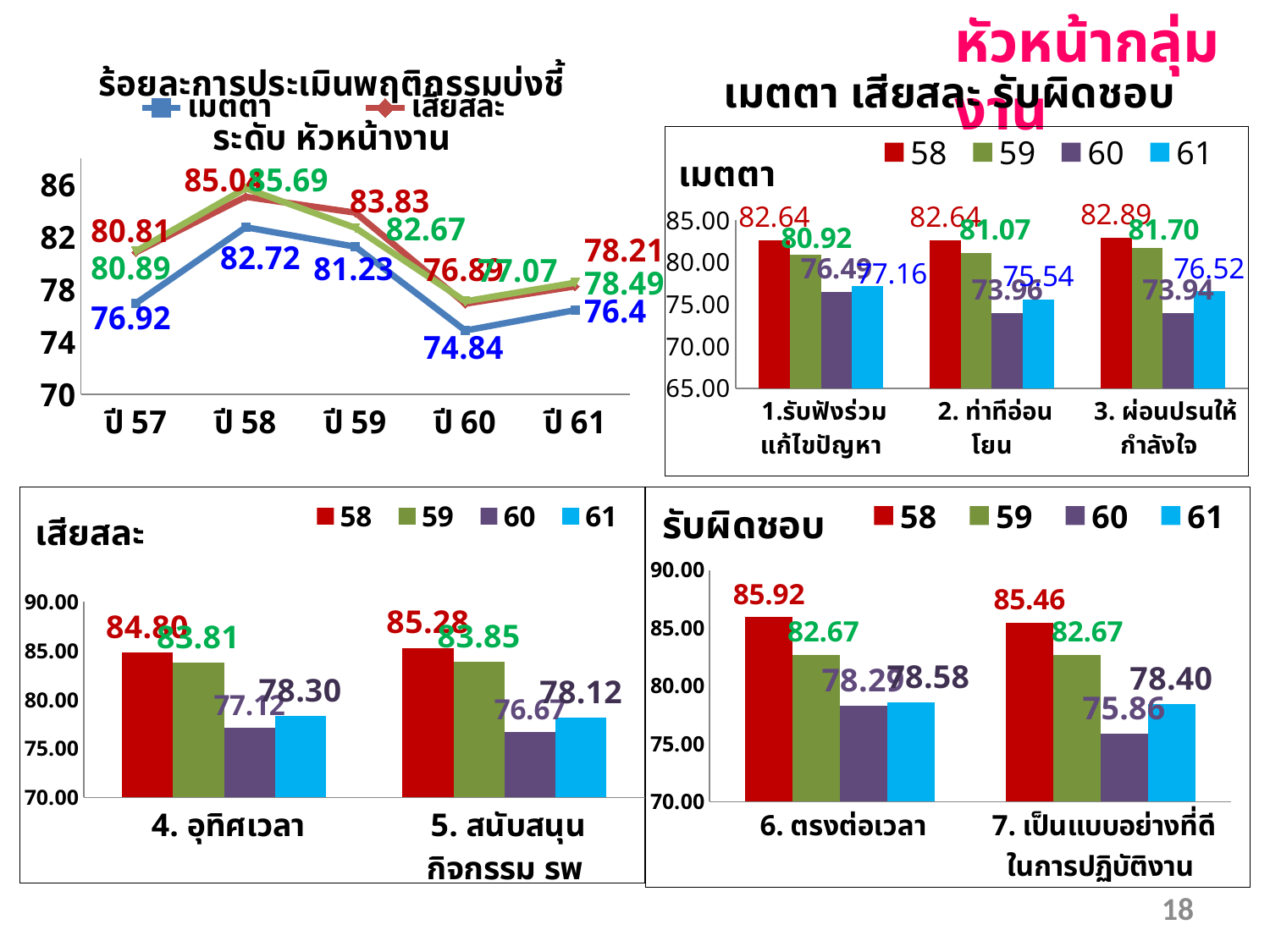
In the bar chart titled เมตตา, what is the value for 58 in category 3. ผ่อนปรนให้กำลังใจ? 82.89 In the bar chart titled รับผิดชอบ, which is larger for 7. เป็นแบบอย่างที่ดีในการปฏิบัติงาน: the value for 60 or the value for 61? 61 In the line chart titled ร้อยละการประเมินพฤติกรรมบ่งชี้ ระดับ หัวหน้างาน, in which year is the เมตตา line lowest? ปี 60 In the bar chart titled เสียสละ, which series has the highest value in category 4. อุทิศเวลา? 58 In the line chart titled ร้อยละการประเมินพฤติกรรมบ่งชี้ ระดับ หัวหน้างาน, how many years are shown on the x axis? 5 In the bar chart titled เมตตา, what is the difference between the 58 and 61 values for 2. ท่าทีอ่อนโยน? 7.10 In the bar chart titled รับผิดชอบ, what is the value for 58 in category 6. ตรงต่อเวลา? 85.92 In the line chart titled ร้อยละการประเมินพฤติกรรมบ่งชี้ ระดับ หัวหน้างาน, what is the value of เสียสละ in ปี 61? 78.21 In the bar chart titled เสียสละ, what is the value for 60 in category 5. สนับสนุนกิจกรรม รพ? 76.67 In the line chart titled ร้อยละการประเมินพฤติกรรมบ่งชี้ ระดับ หัวหน้างาน, what is the value of เมตตา in ปี 58? 82.72 What kind of chart is the chart titled รับผิดชอบ? bar chart In the bar chart titled เมตตา, how many series does the legend list? 4